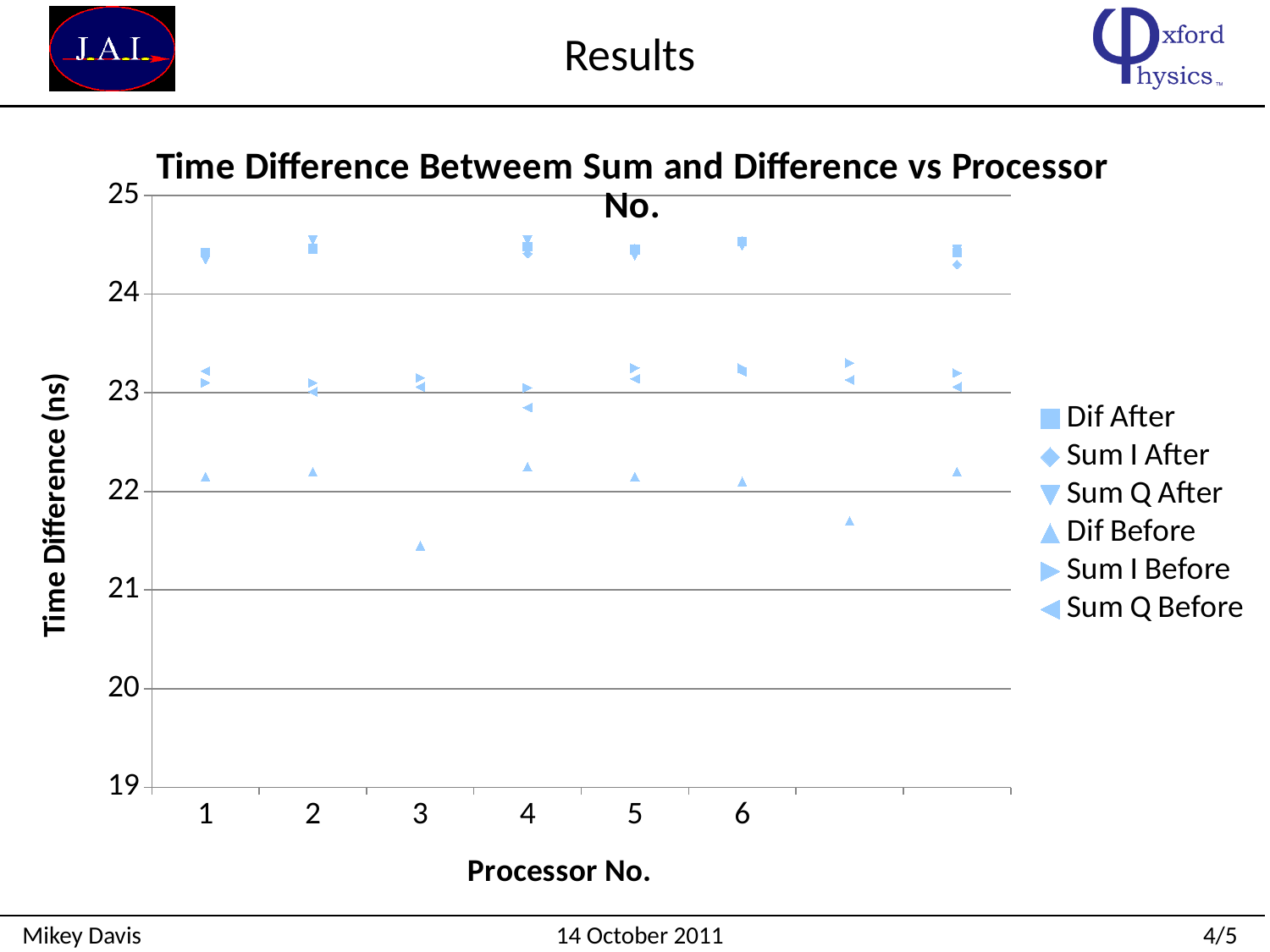
Is the Dif Before value for processor 3 greater or less than 22? less For processor 3, which is larger: Sum I Before or Dif Before? Sum I Before Which labelled processor has the lowest Dif Before value? 3 What is the title of the chart? Time Difference Betweem Sum and Difference vs Processor No. Is the Sum Q Before value for processor 4 greater or less than 23? less How many processor numbers are labelled on the x axis? 6 How many series does the legend list? 6 What kind of chart is shown on the slide? scatter chart For processor 1, which is larger: Dif After or Dif Before? Dif After What is the label of the y axis? Time Difference (ns) Is the Dif After value for processor 1 greater or less than 24? greater